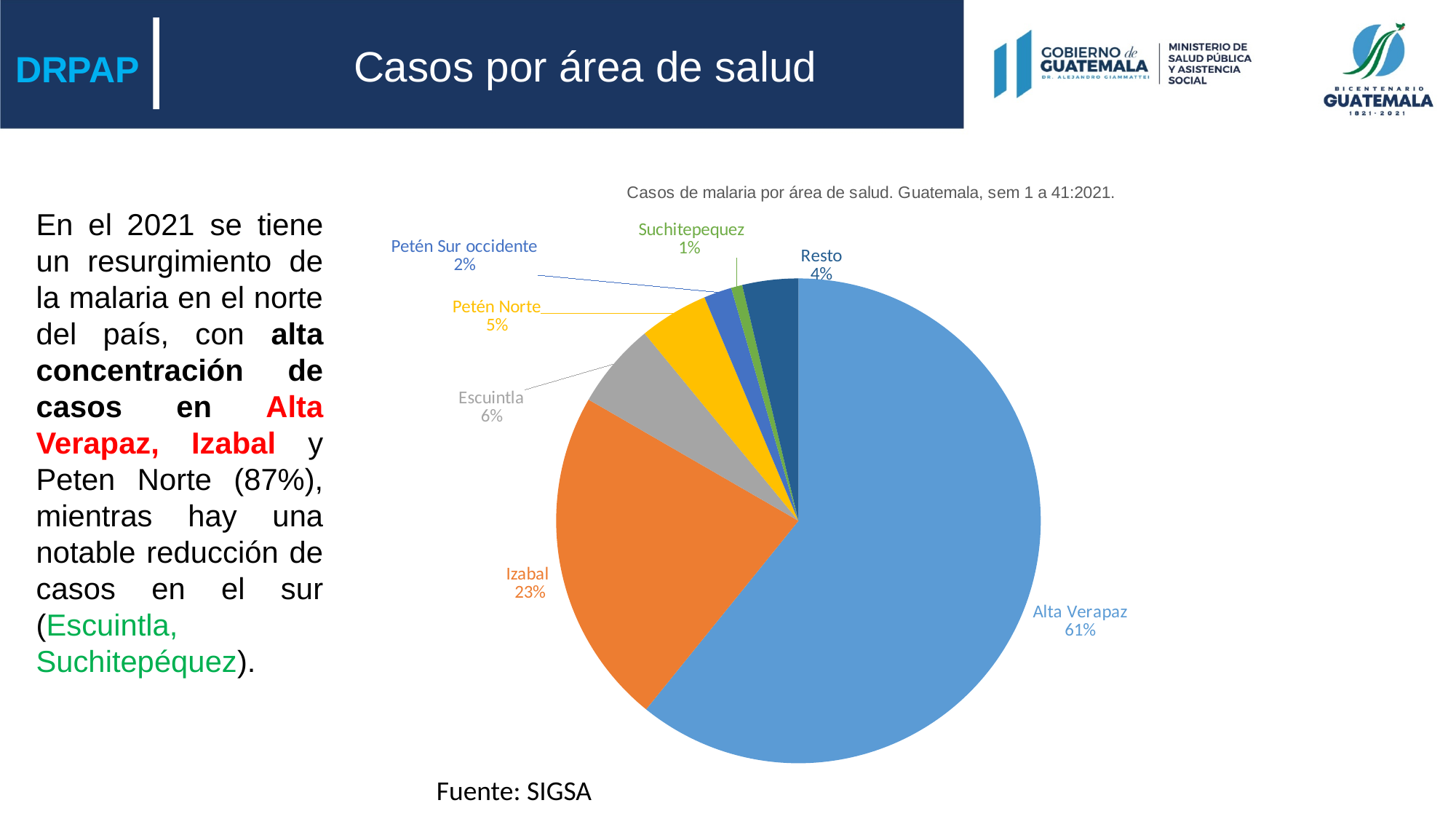
Which has a larger share, Escuintla or Resto? Escuintla How many slices does the pie chart have? 7 What percentage is shown for Escuintla? 6% Which area has the largest share of cases? Alta Verapaz What percentage is shown for Petén Norte? 5% What percentage is shown for Izabal? 23% What percentage is shown for Suchitepequez? 1% Which area has the smallest share of cases? Suchitepequez What is the difference in percentage points between Alta Verapaz and Izabal? 38 What is the title of the chart? Casos de malaria por área de salud. Guatemala, sem 1 a 41:2021. What kind of chart is shown on the slide? Pie chart What share of malaria cases does Alta Verapaz account for? 61%